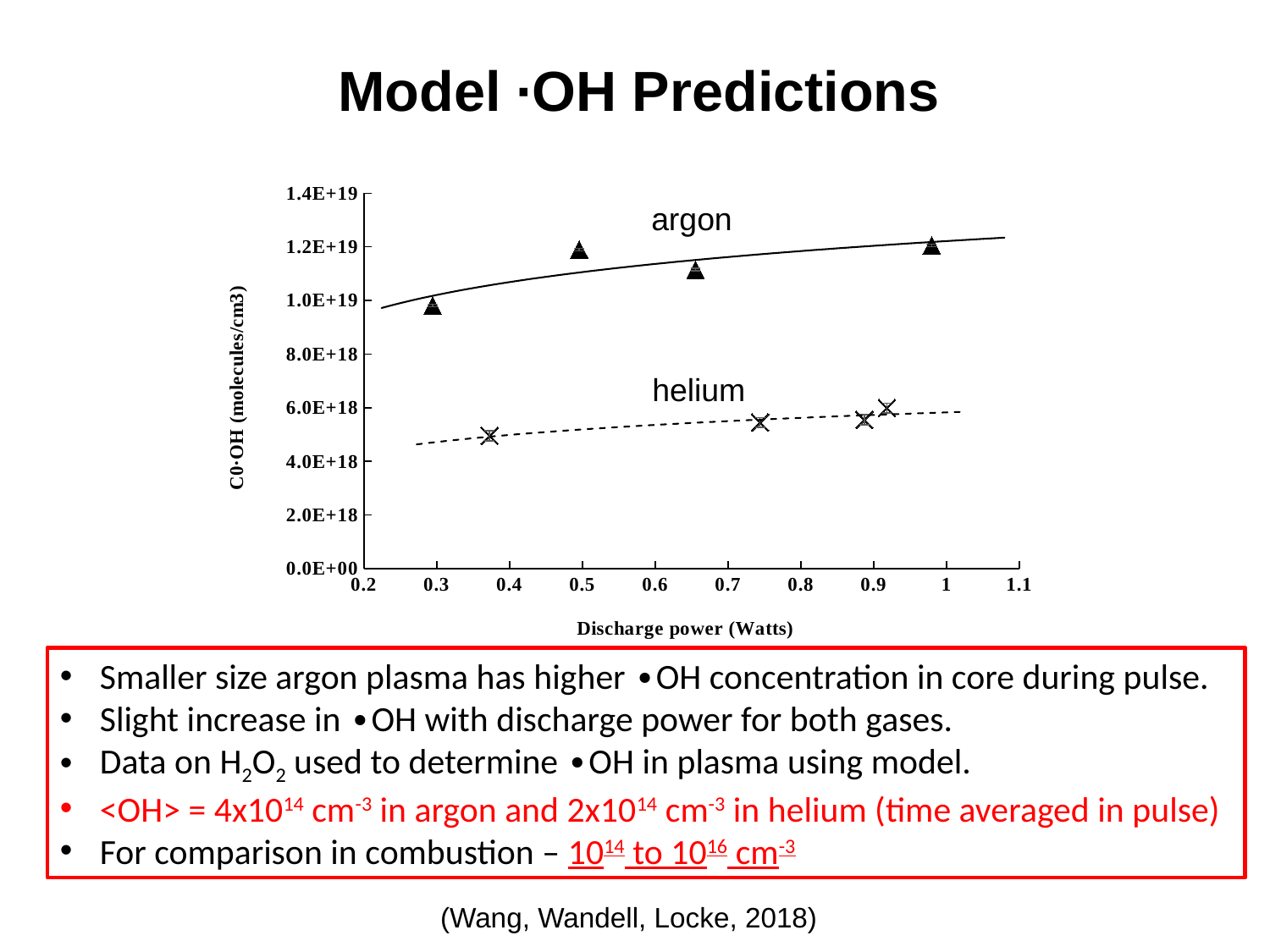
Which two gases are labelled on the chart? argon and helium What is the label of the x axis? Discharge power (Watts) Which series has the higher ·OH concentration, argon or helium? argon Is the helium value at a discharge power of about 0.37 W greater or less than 6.0E+18? less How many helium data points (x markers) are plotted? 4 Are all the helium data points greater or less than 8.0E+18? less How many argon data points (triangles) are plotted? 4 Is the argon value at a discharge power of about 0.5 W greater or less than 1.0E+19? greater What kind of chart is shown on the slide? scatter chart with trend lines How many data series are plotted on the chart? 2 Does the ·OH concentration rise or fall as discharge power increases for both gases? rise